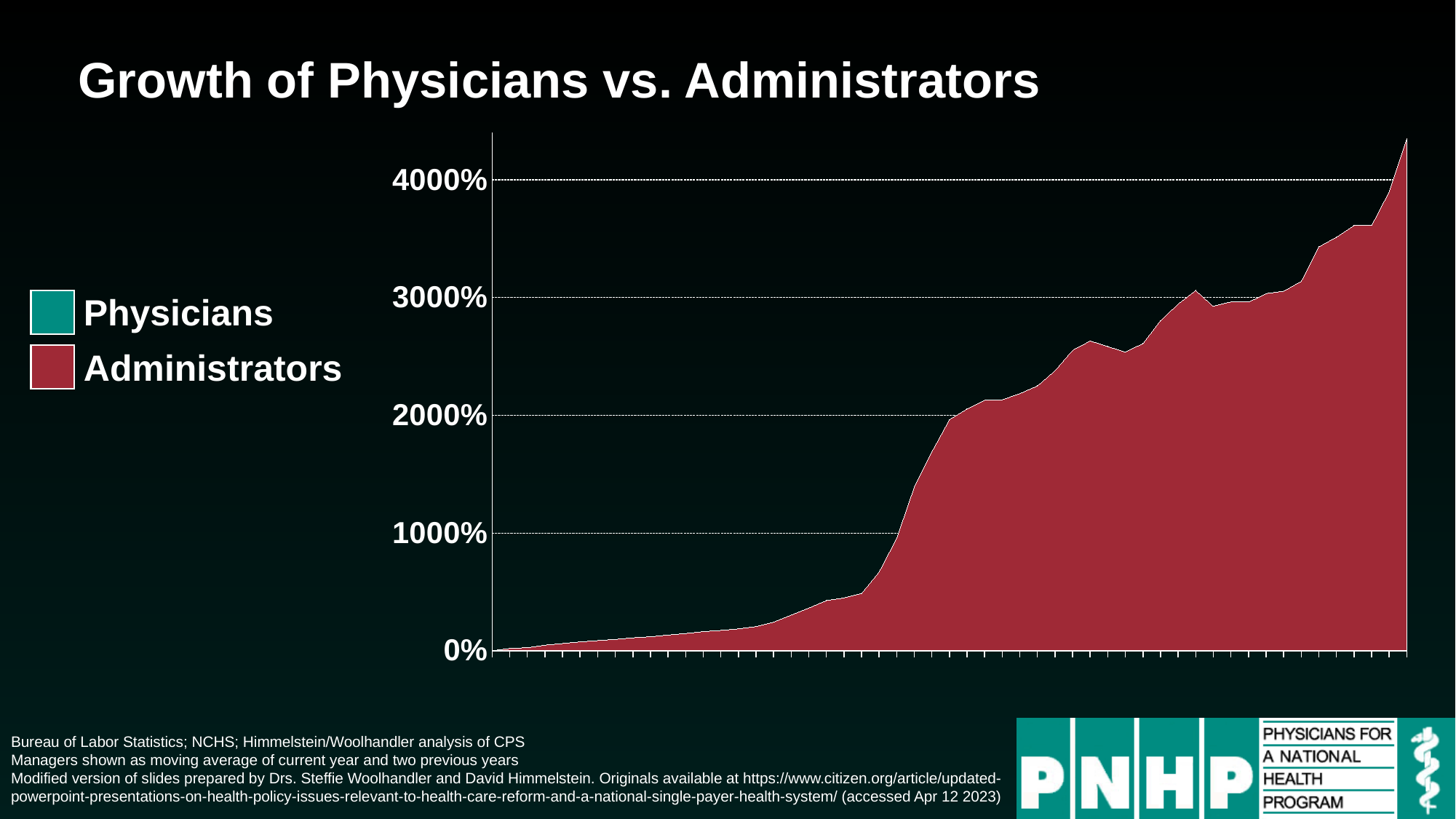
How many series does the legend list? 2 Does the Administrators series generally rise or fall from left to right along the x axis? rise Which series reaches the higher values on the chart, Physicians or Administrators? Administrators Which series is shown in red on the chart? Administrators Is the Administrators value at the far right end of the chart greater or less than 4000%? greater Is the Administrators value at the far left end of the chart greater or less than 1000%? less What is the highest value labelled on the y axis? 4000% What kind of chart is shown on the slide? area chart What is the title of the chart? Growth of Physicians vs. Administrators